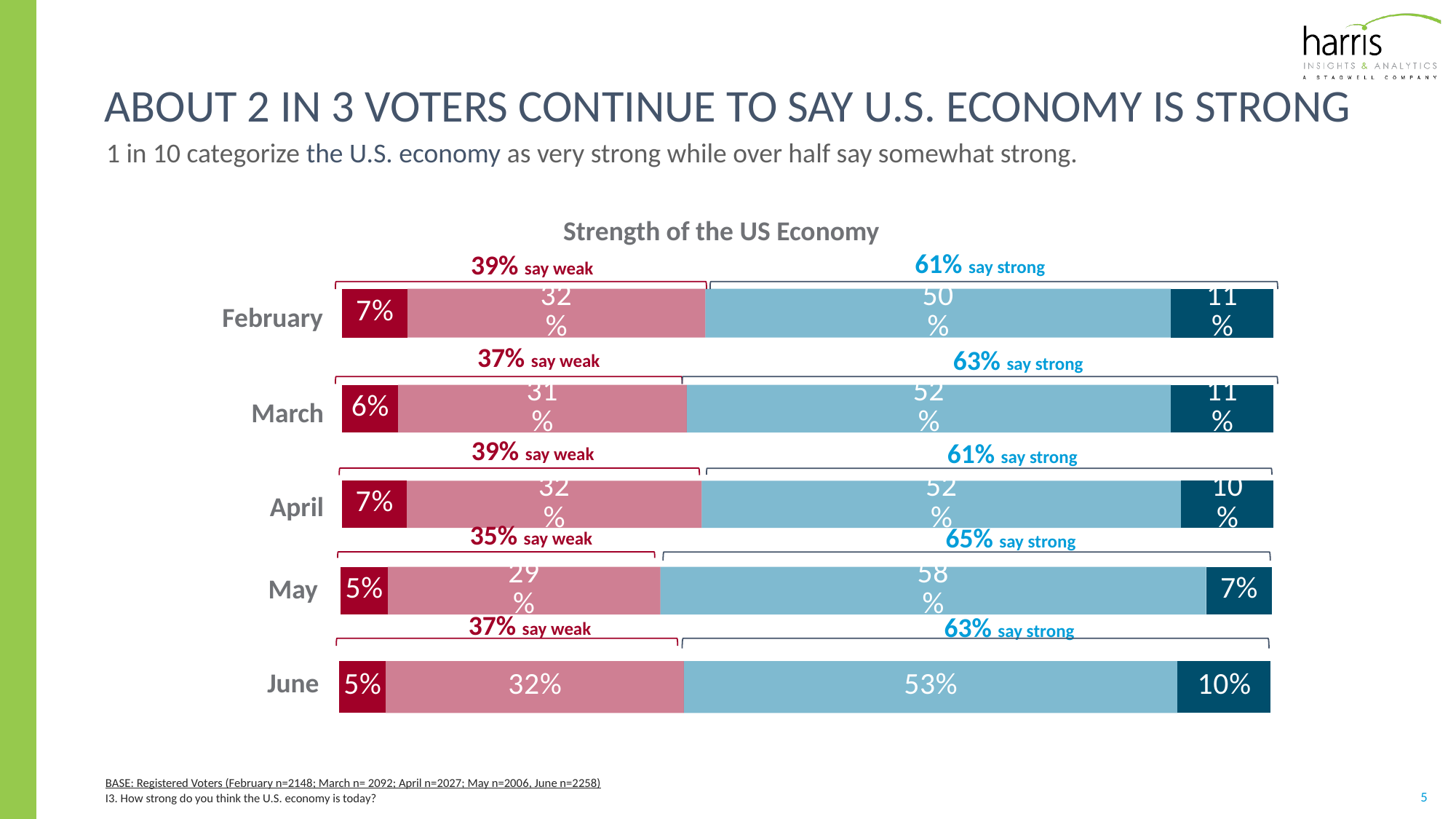
Which is larger: the light blue segment for May or the light blue segment for February? May What is the value of the dark red (leftmost) segment for May? 5% What kind of chart is shown on the slide? Stacked bar chart How many months (categories) are shown in the chart? 5 In which month was the share saying the economy is strong the highest? May What is the chart's title? Strength of the US Economy What percentage of voters said the economy was strong in May? 65% What is the total of the two weak segments (dark red and pink) for June? 37% What percentage of voters said the economy was weak in February? 39% What is the value of the dark blue (very strong) segment for March? 11% What is the difference between the 'say strong' percentage in May and in April? 4 percentage points What is the value of the light blue (somewhat strong) segment for June? 53%